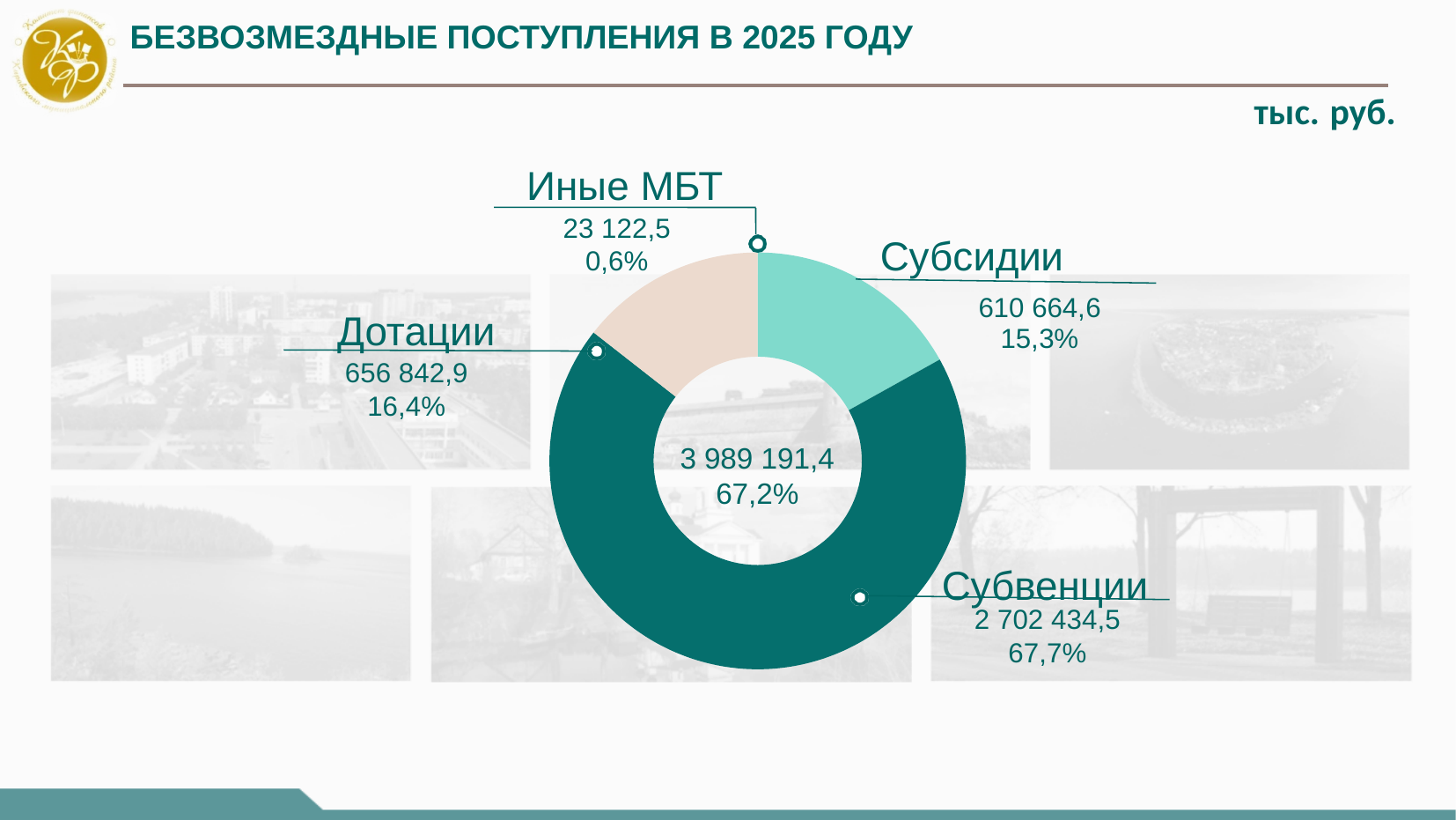
Which category has the largest value? Субвенции What share of the chart does Субсидии account for? 15,3% What is the value for Иные МБТ? 23 122,5 What share of the chart does Субвенции account for? 67,7% Which category has the smallest value? Иные МБТ Which is larger, the value for Дотации or the value for Субсидии? Дотации What is the difference between the values for Дотации and Субсидии? 46 178,3 What kind of chart is shown on the slide? Pie (donut) chart What is the value for Субсидии? 610 664,6 What is the value for Дотации? 656 842,9 How many categories are shown in the chart? 4 What is the value for Субвенции? 2 702 434,5